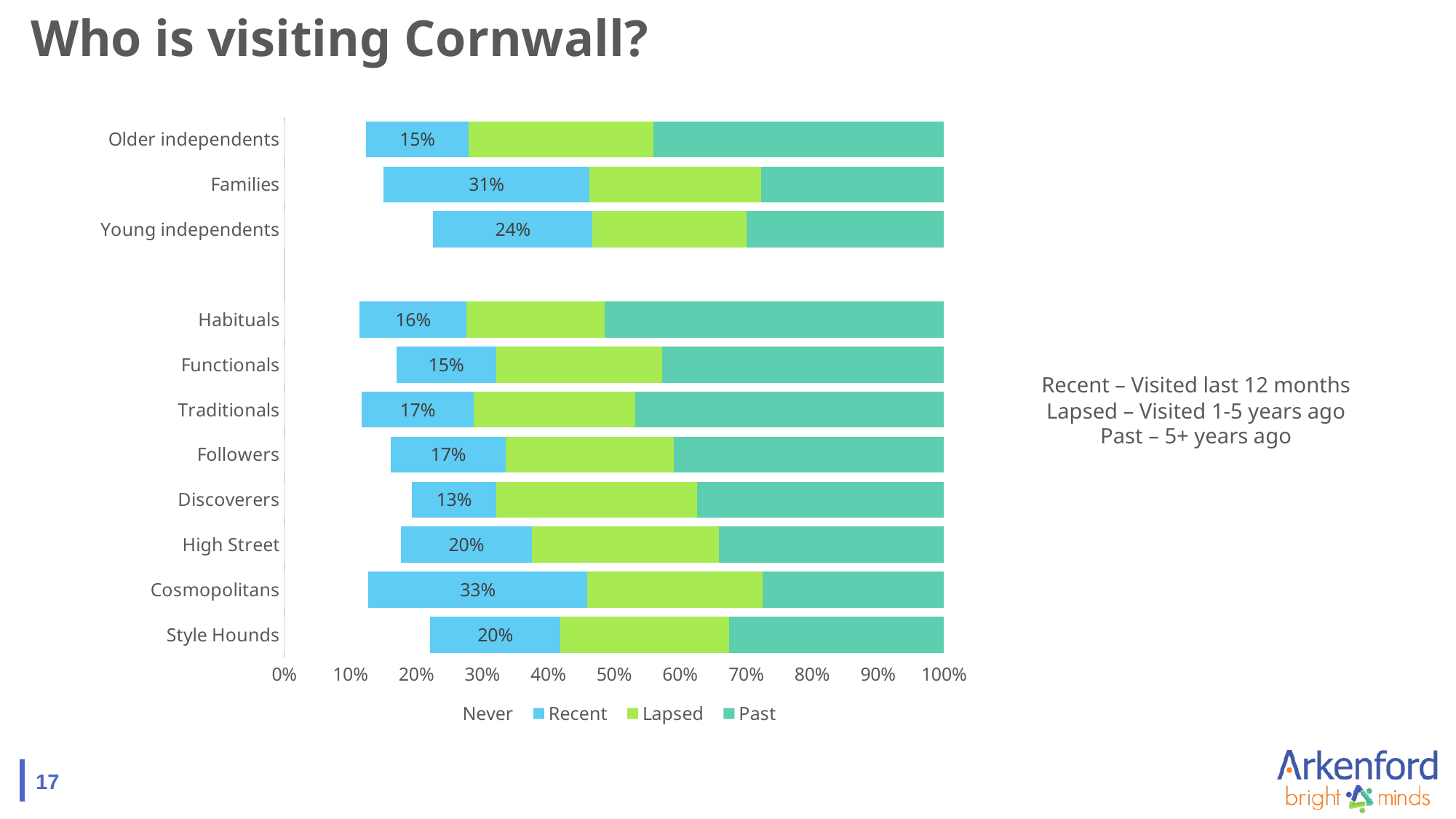
What kind of chart is shown on the slide? Stacked bar chart How many series does the legend list? 4 Which category has the lowest Recent value? Discoverers What is the difference between the Recent values for Families and Older independents? 16 percentage points Which has a larger Recent value, Families or Young independents? Families Is the Past value for Habituals greater or less than 50%? greater How many labelled categories are shown on the chart? 11 What is the Recent value for Cosmopolitans? 33% Which category has the highest Recent value? Cosmopolitans Is the Never value for Young independents greater or less than 20%? greater What is the Recent value for Discoverers? 13% What is the Recent value for Families? 31%